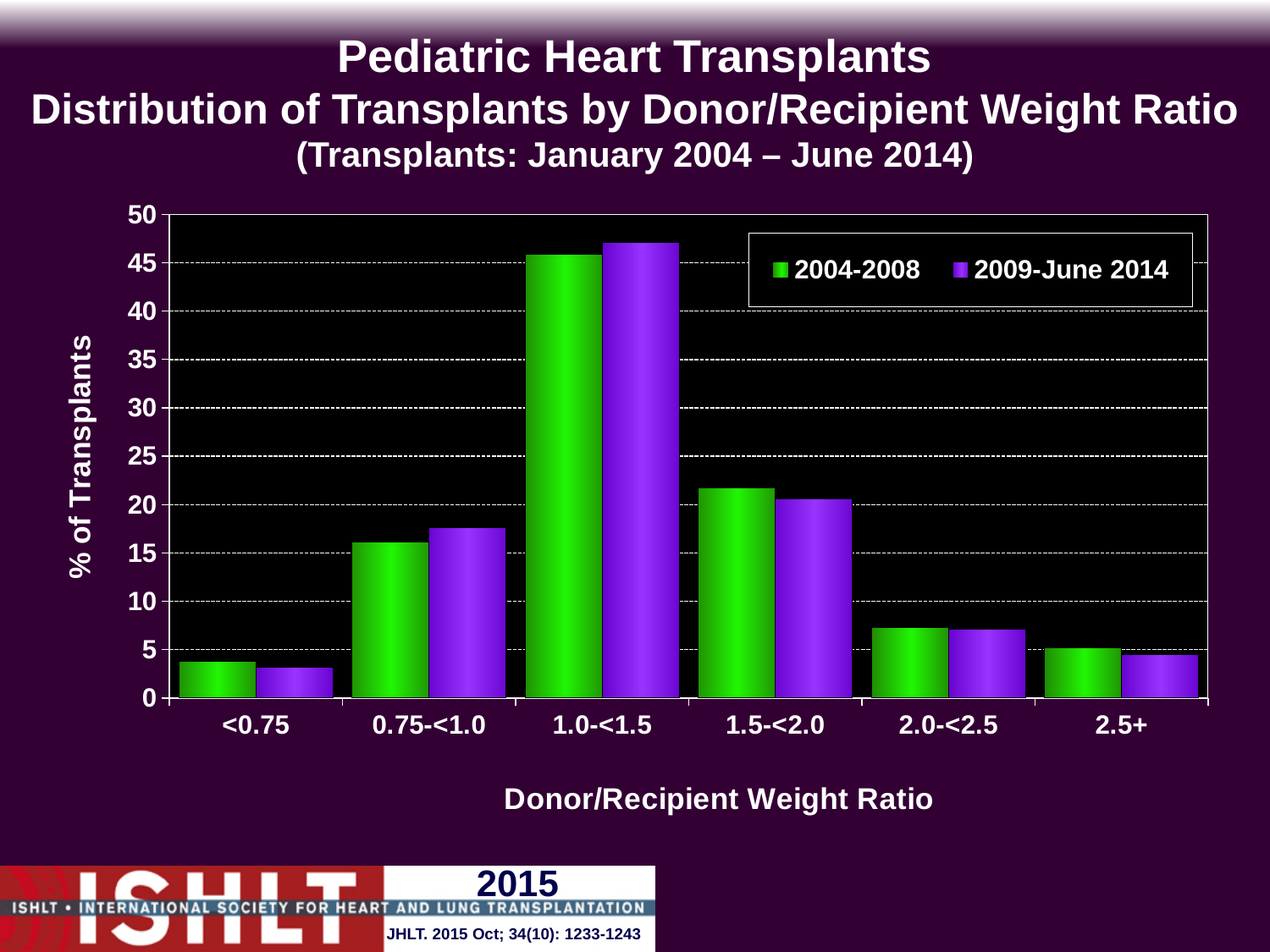
What kind of chart is shown on the slide? bar chart Which weight ratio category has the highest value for the 2004-2008 series? 1.0-<1.5 Is the value for 2009-June 2014 in the 0.75-<1.0 category greater or less than 15? greater How many donor/recipient weight ratio categories are shown on the x axis? 6 Is the value for 2009-June 2014 in the 1.5-<2.0 category greater or less than 25? less Which weight ratio category has the lowest value for the 2009-June 2014 series? <0.75 Is the value for 2004-2008 in the 2.0-<2.5 category greater or less than 10? less In the 0.75-<1.0 category, which series has the larger value, 2004-2008 or 2009-June 2014? 2009-June 2014 What are the two series named in the legend? 2004-2008 and 2009-June 2014 What is the label of the y axis? % of Transplants How many series does the legend list? 2